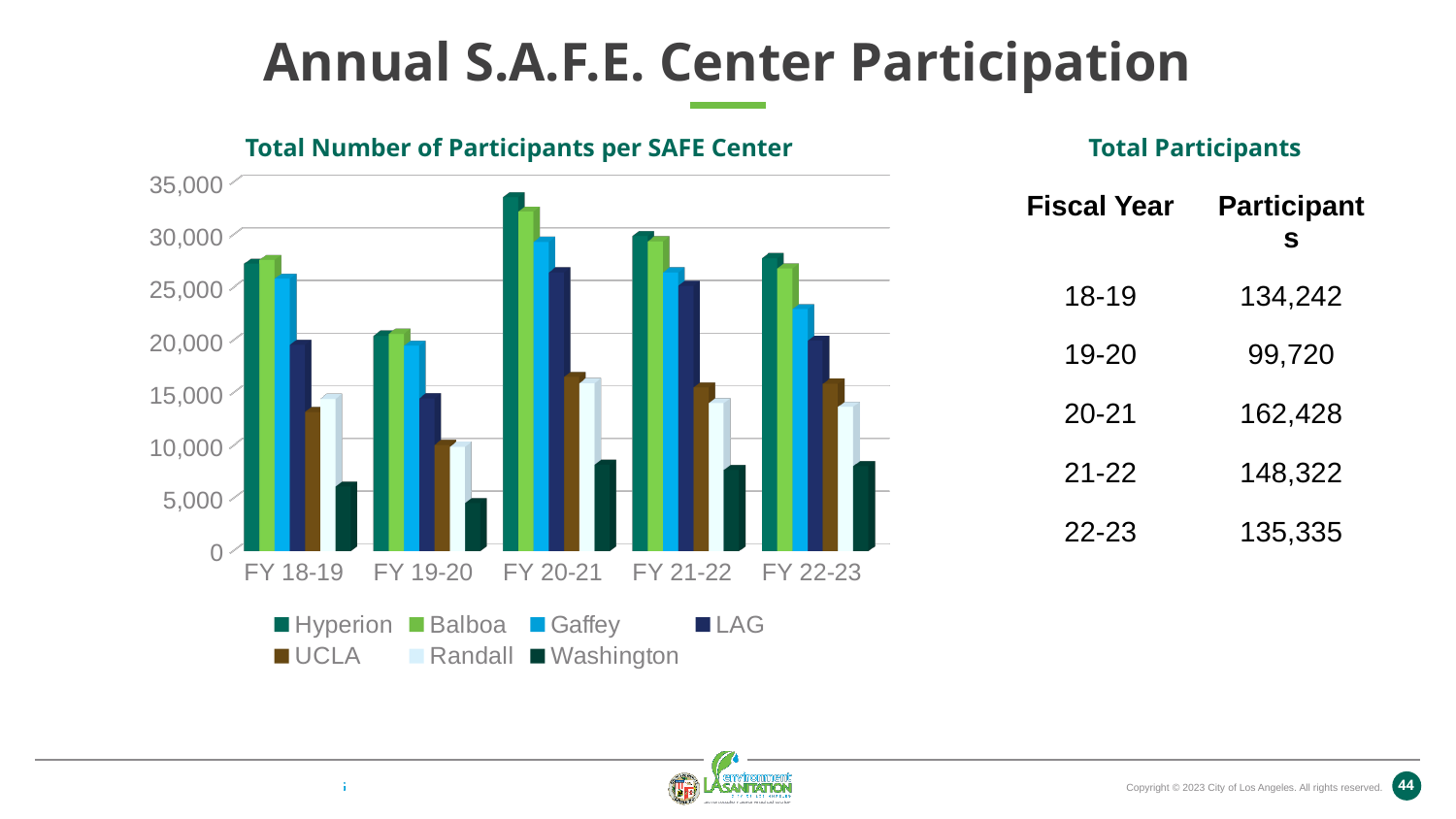
What is the title of the chart on the slide? Total Number of Participants per SAFE Center Is the value for Washington in FY 19-20 greater or less than 5,000? less Is the value for LAG in FY 21-22 greater or less than 20,000? greater How many series does the chart's legend list? 7 How many fiscal years are shown on the x axis of the chart? 5 In which fiscal year does Hyperion have its highest number of participants? FY 20-21 Is the value for Hyperion in FY 20-21 greater or less than 30,000? greater Which is larger in FY 19-20, the value for Balboa or the value for Randall? Balboa Which SAFE center has the lowest number of participants in FY 18-19? Washington What kind of chart is shown under the title "Total Number of Participants per SAFE Center"? Bar chart In which fiscal year does Hyperion have its lowest number of participants? FY 19-20 Which is larger in FY 22-23, the value for Gaffey or the value for UCLA? Gaffey